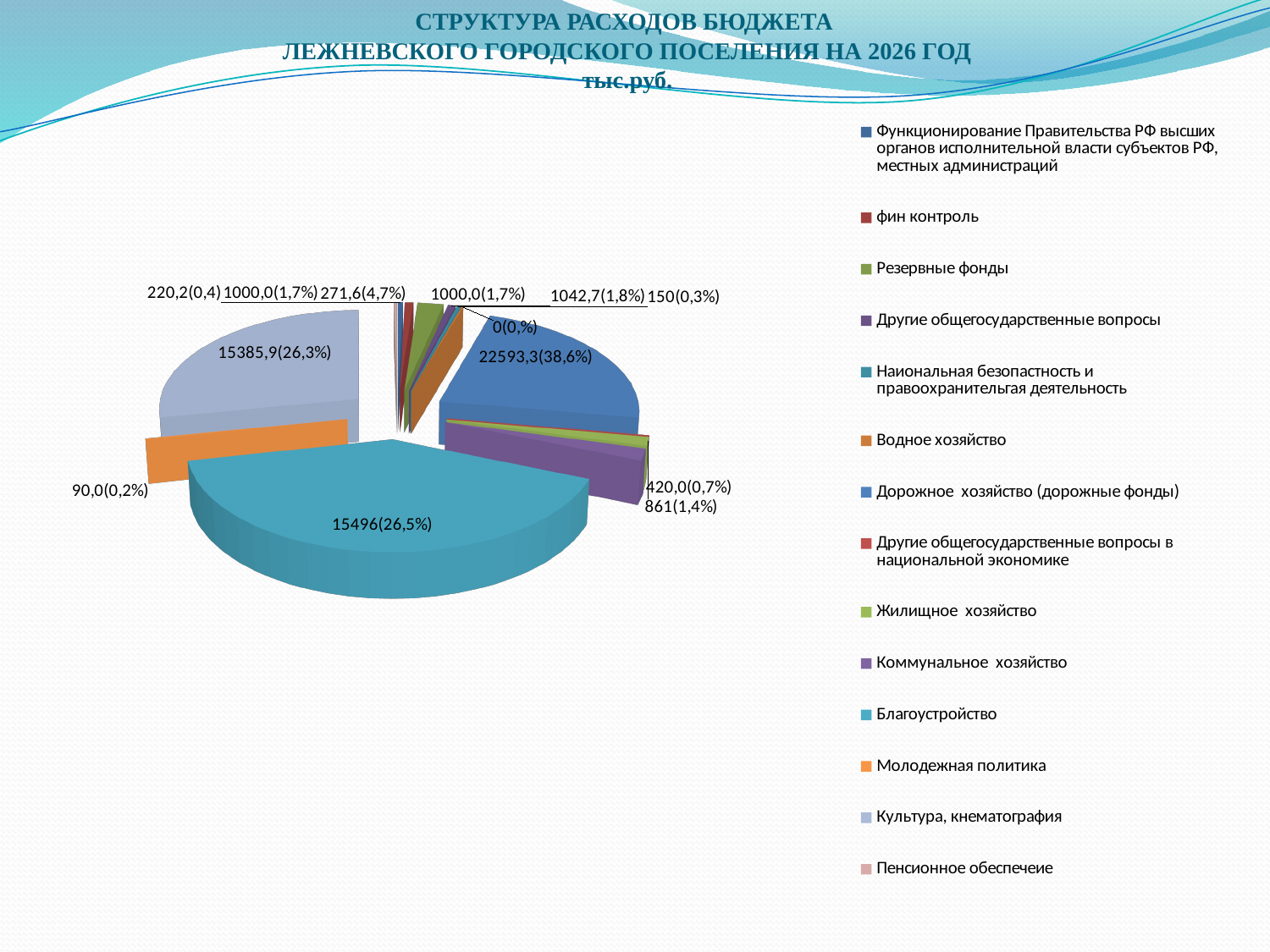
What is the difference between the Благоустройство value (15496) and the Культура, кнематография value (15385,9)? 110,1 What is the smallest data label shown on the pie chart? 0(0,%) What share of the pie does the Благоустройство slice represent? 26,5% Which is larger according to the data labels: the Благоустройство slice (15496) or the Культура, кнематография slice (15385,9)? Благоустройство What is the data label of the teal slice for Благоустройство? 15496(26,5%) What is the title of the chart on the slide? СТРУКТУРА РАСХОДОВ БЮДЖЕТА ЛЕЖНЕВСКОГО ГОРОДСКОГО ПОСЕЛЕНИЯ НА 2026 ГОД тыс.руб. What kind of chart is shown on the slide? pie chart How many entries does the legend of the pie chart list? 14 In what units are the values on the chart given, according to the title? тыс.руб. What is the data label of the light blue slice for Культура, кнематография? 15385,9(26,3%)